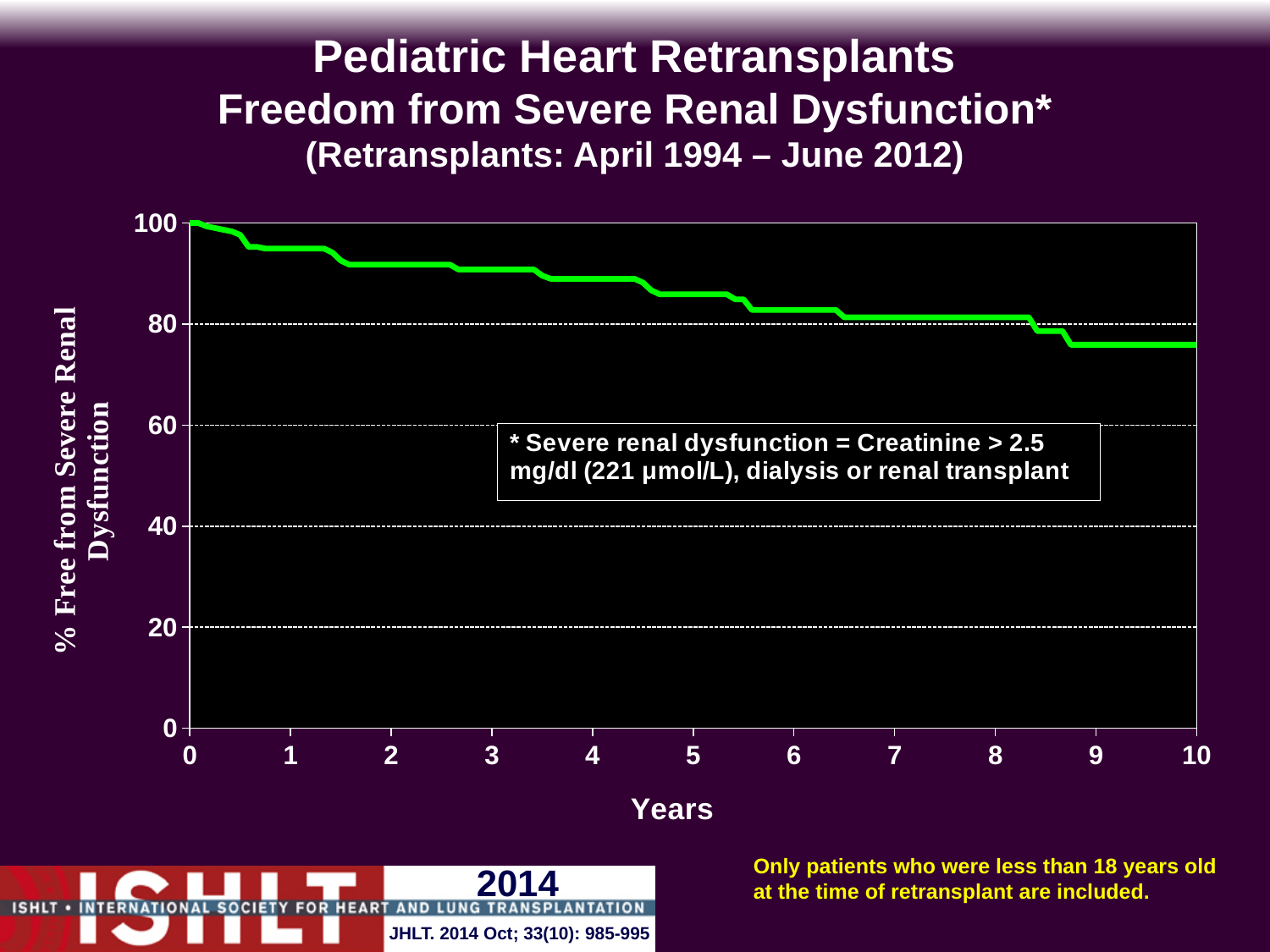
Which is larger, the value at year 2 or the value at year 8? Year 2 What is the label of the x axis? Years What is the value of the curve at year 0? 100 Does the percentage free from severe renal dysfunction rise or fall as years increase? Fall Is the value at year 5 greater or less than 80? greater Is the value at year 10 greater or less than 80? less At which year is the curve at its highest value? Year 0 What colour is the plotted line? Green Is the value at year 1 greater or less than 90? greater What kind of chart is shown on the slide? Line chart